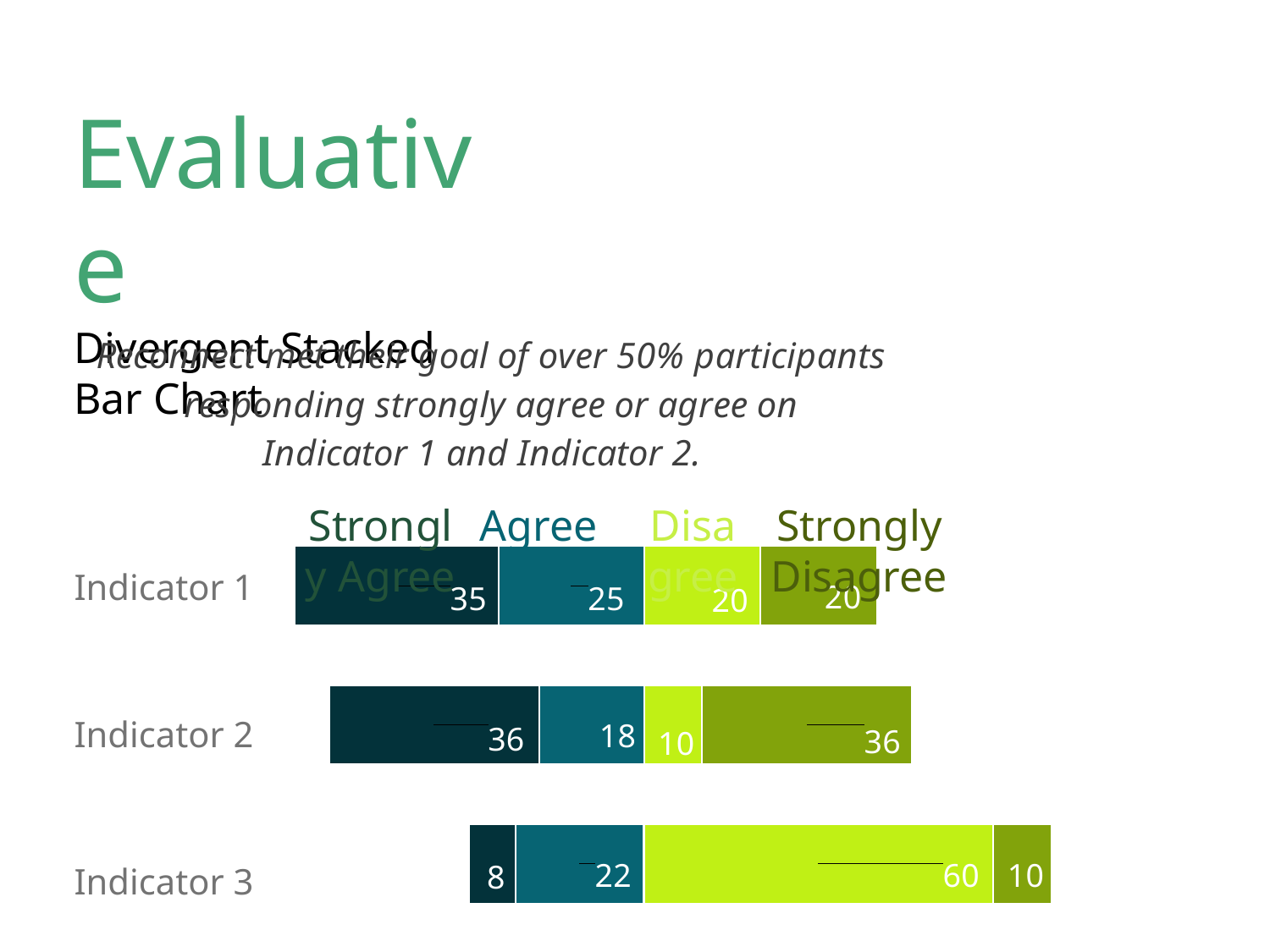
How many series does the legend list? 4 Which indicator has the highest Strongly Agree value? Indicator 2 How many indicators are shown in the chart? 3 What kind of chart is shown on the slide? Stacked bar chart What is the difference between the Strongly Disagree values for Indicator 2 and Indicator 1? 16 Which indicator has the lowest Disagree value? Indicator 2 What is the Strongly Disagree value for Indicator 2? 36 What is the Agree value for Indicator 2? 18 Which is larger, the Agree value for Indicator 1 or the Agree value for Indicator 3? Indicator 1 What is the Strongly Agree value for Indicator 1? 35 What is the total of the stacked bar for Indicator 3? 100 What is the Disagree value for Indicator 3? 60